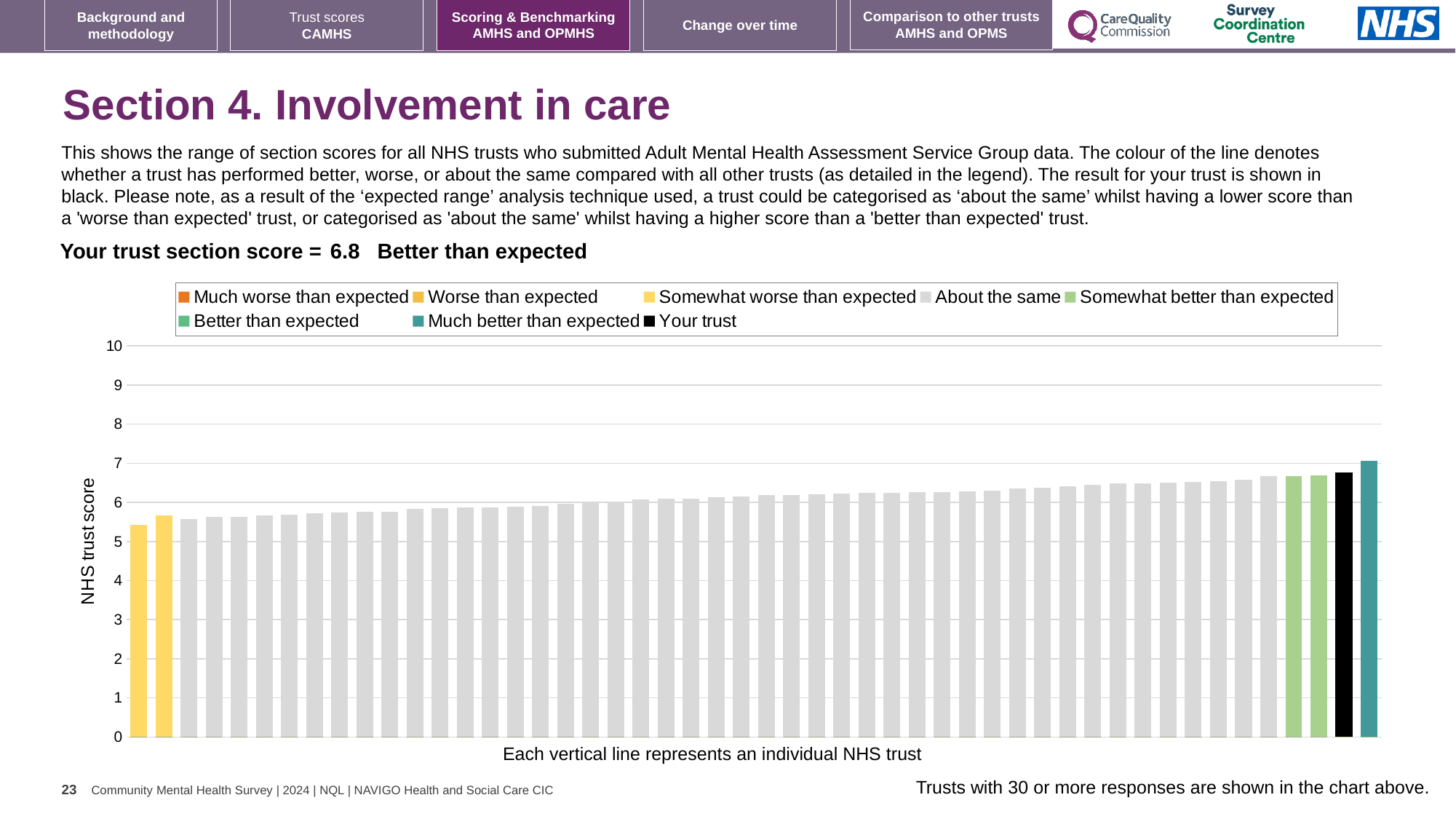
What is the section score for your trust? 6.8 What kind of chart is shown on the slide? bar chart Which legend category do the lowest bars in the chart belong to? Somewhat worse than expected What is the label on the vertical axis of the chart? NHS trust score How many entries does the chart legend list? 8 Is the value for your trust greater or less than 6? greater Which legend category does the highest bar in the chart belong to? Much better than expected Do the bar values rise or fall from left to right across the chart? rise Is the value of the lowest bar greater or less than 5? greater Is the value of the lowest bar greater or less than 6? less Which performance category is your trust placed in for this section? Better than expected Which is higher: the bar for your trust or the rightmost (teal) bar? the rightmost (teal) bar